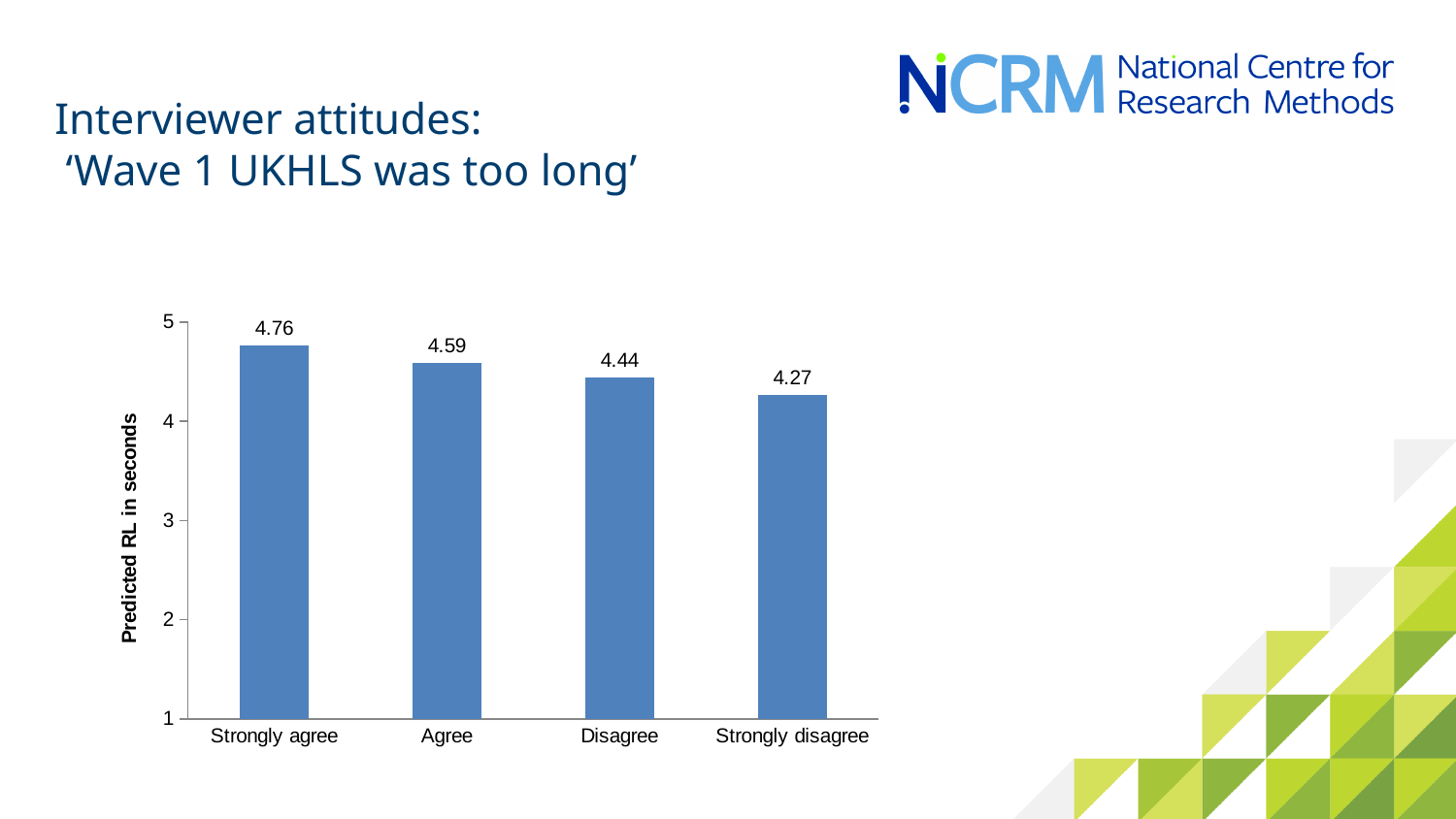
What is the predicted RL in seconds for 'Agree'? 4.59 What kind of chart is shown on the slide? Bar chart What is the predicted RL in seconds for 'Strongly disagree'? 4.27 What is the predicted RL in seconds for 'Strongly agree'? 4.76 Which has a higher predicted RL, 'Agree' or 'Disagree'? Agree How many categories are shown on the x axis? 4 Which category has the highest predicted RL? Strongly agree Is the value for 'Strongly disagree' greater or less than 4? greater Which category has the lowest predicted RL? Strongly disagree Do the values rise or fall moving from 'Strongly agree' to 'Strongly disagree'? Fall What is the difference in predicted RL between 'Strongly agree' and 'Strongly disagree'? 0.49 What is the predicted RL in seconds for 'Disagree'? 4.44